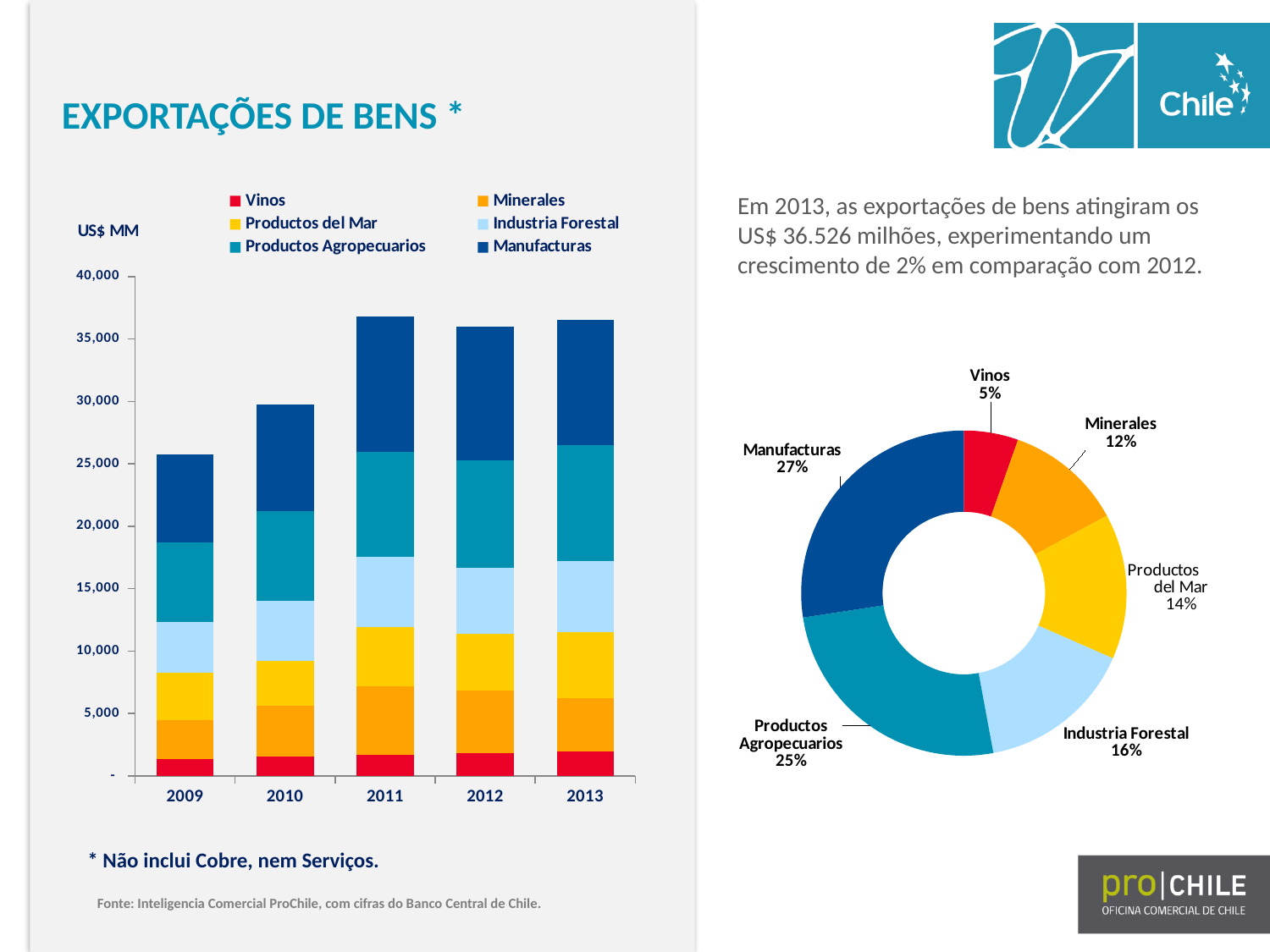
In the donut chart on the right, how many categories are shown? 6 In the donut chart on the right, what is the difference in percentage points between Productos Agropecuarios and Minerales? 13 percentage points In the stacked bar chart on the left, which year has the lowest total exports? 2009 In the stacked bar chart on the left, how many series does the legend list? 6 In the donut chart on the right, which is larger: the share of Productos del Mar or the share of Industria Forestal? Industria Forestal In the donut chart on the right, what share does Industria Forestal represent? 16% What type of chart is shown on the left side of the slide? Stacked bar chart In the donut chart on the right, what share do Manufacturas represent? 27% In the donut chart on the right, which category has the largest share? Manufacturas In the donut chart on the right, what share do Productos Agropecuarios represent? 25% In the donut chart on the right, which category has the smallest share? Vinos